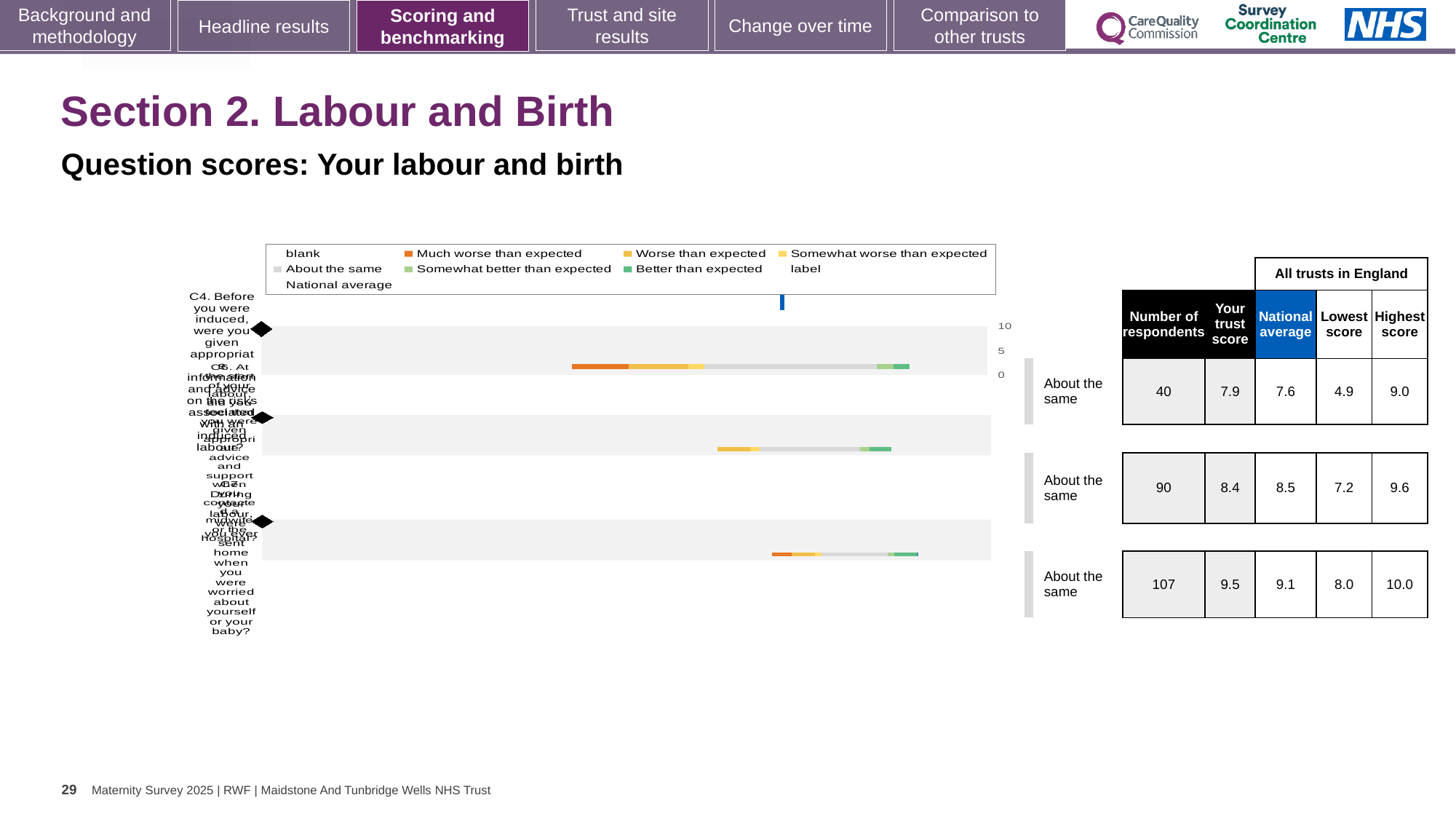
In the chart legend, what colour represents "Better than expected"? green In the table beside the chart, what is the difference between the highest score and the lowest score for the first (top) row? 4.1 In the table beside the chart, which row has the lowest number of respondents? the first (top) row In the table beside the chart, which row has the highest "Your trust score"? the third (bottom) row In the table beside the chart, is the trust score for the second row higher or lower than its national average? lower What kind of chart is shown on the slide? bar chart In the table beside the chart, what is the national average for the third (bottom) row? 9.1 How many question bars are plotted in the chart? 3 In the chart legend, what colour represents "Much worse than expected"? orange What benchmark label is shown next to each of the three chart rows? About the same In the table beside the chart, what is the number of respondents for the first (top) row? 40 In the table beside the chart, what is the "Your trust score" for the third (bottom) row? 9.5